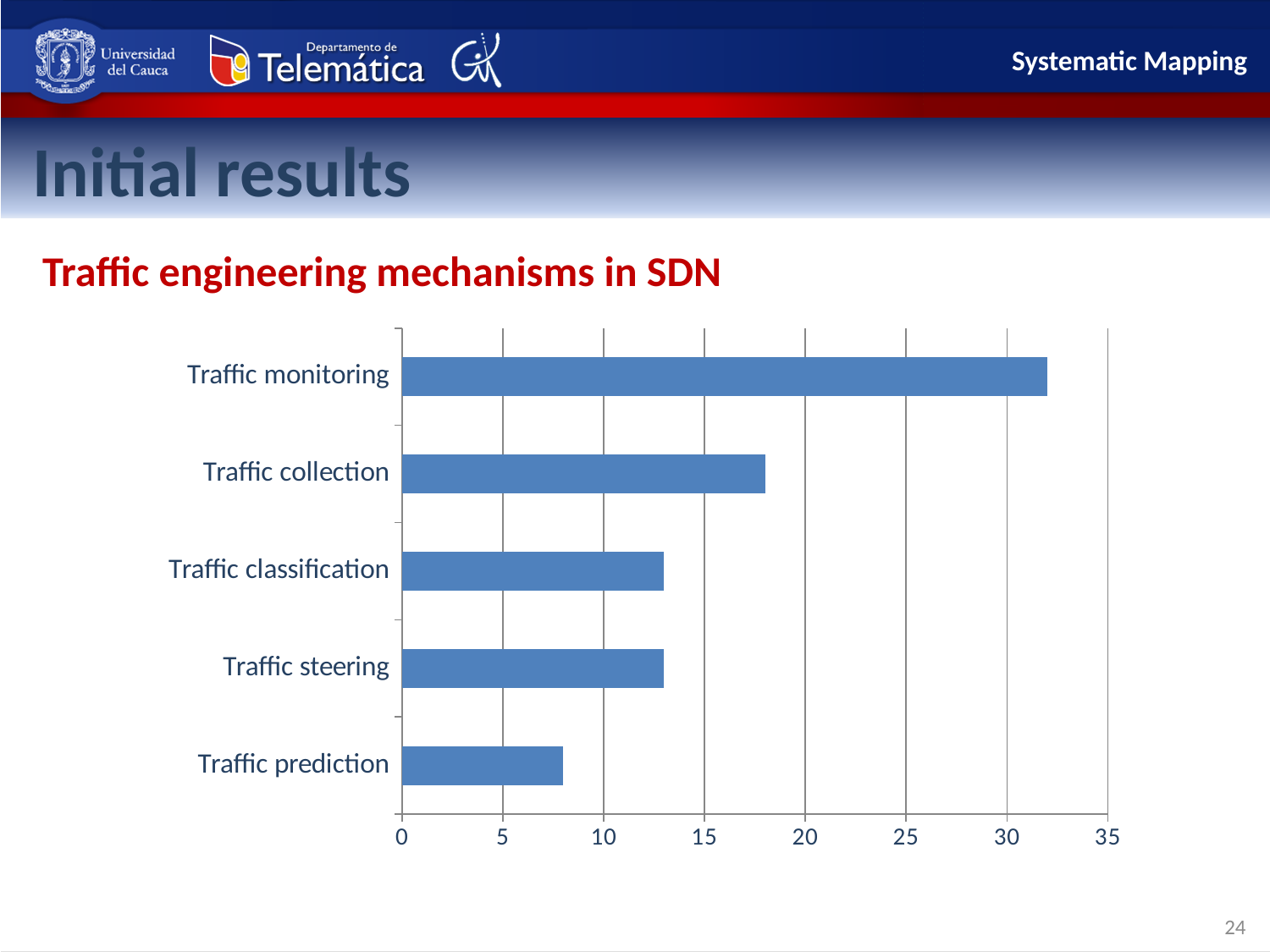
Is the value for Traffic collection greater or less than 15? greater Is the value for Traffic collection greater or less than 20? less Is the value for Traffic monitoring greater or less than 30? greater Which category has the highest value? Traffic monitoring What kind of chart is shown on the slide? bar chart Which is larger, the value for Traffic collection or the value for Traffic prediction? Traffic collection What is the title shown above the chart? Traffic engineering mechanisms in SDN Which category has the lowest value? Traffic prediction How many categories are plotted in the chart? 5